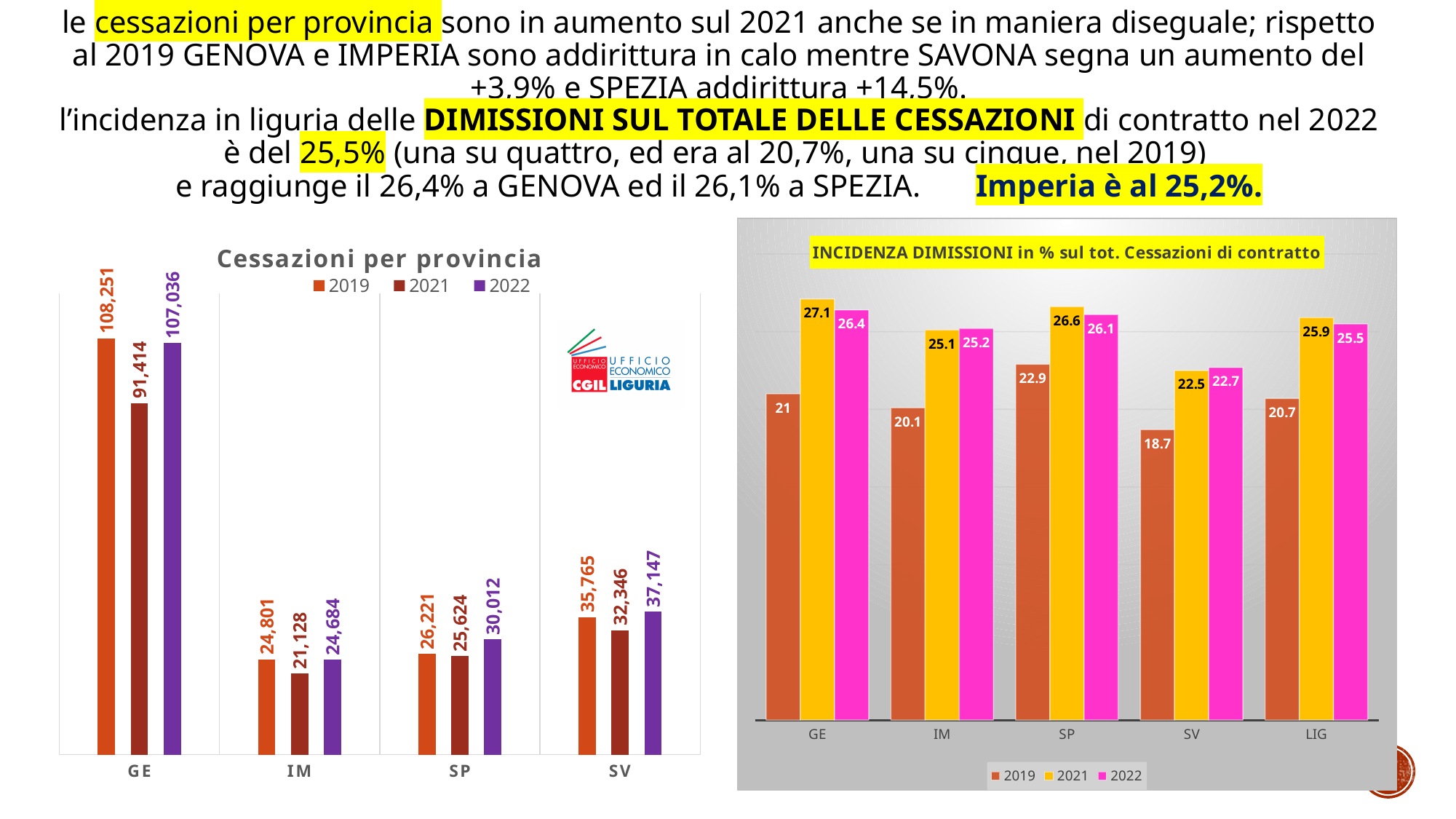
In the 'Cessazioni per provincia' chart, what is the value for GE in 2022? 107,036 In the 'INCIDENZA DIMISSIONI' chart, how many series does the legend list? 3 In the 'INCIDENZA DIMISSIONI' chart, what is the value for SV in 2019? 18.7 In the 'INCIDENZA DIMISSIONI' chart, is the 2022 value for GE larger or smaller than the 2022 value for SP? larger In the 'INCIDENZA DIMISSIONI' chart, what is the value for LIG in 2022? 25.5 In the 'Cessazioni per provincia' chart, which province has the lowest value in 2021? IM In the 'Cessazioni per provincia' chart, which province has the highest value in 2019? GE In the 'Cessazioni per provincia' chart, what kind of chart is it? Bar chart In the 'Cessazioni per provincia' chart, what is the value for SV in 2021? 32,346 In the 'INCIDENZA DIMISSIONI' chart, which category has the highest value in 2021? GE In the 'Cessazioni per provincia' chart, what is the difference between the 2022 and 2019 values for SP? 3,791 In the 'Cessazioni per provincia' chart, how many provinces are shown on the x axis? 4